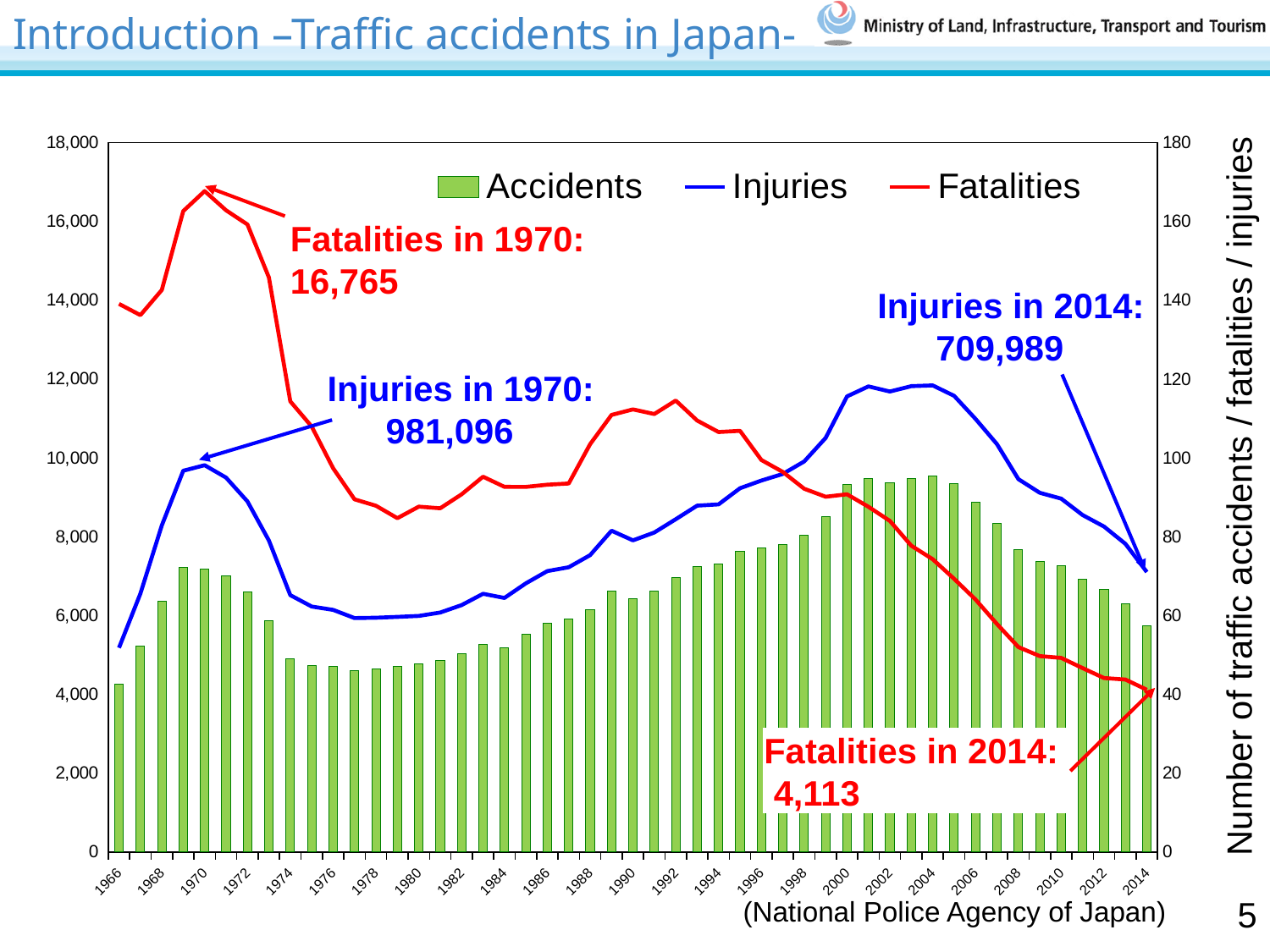
Is the Accidents bar for 2004 greater or less than 8,000 on the left axis? greater What was the number of injuries in 2014 according to the annotation on the chart? 709,989 What source is cited below the chart? National Police Agency of Japan What was the number of injuries in 1970 according to the annotation on the chart? 981,096 In which year does the Fatalities line reach its peak? 1970 Does the Fatalities line rise or fall from 1992 to 2014? fall What was the number of fatalities in 1970 according to the annotation on the chart? 16,765 Which year had more fatalities, 1970 or 2014? 1970 Is the Accidents bar for 1966 greater or less than 6,000 on the left axis? less How many series does the legend list? 3 By how much did fatalities fall between 1970 and 2014, using the annotated values? 12,652 What was the number of fatalities in 2014 according to the annotation on the chart? 4,113